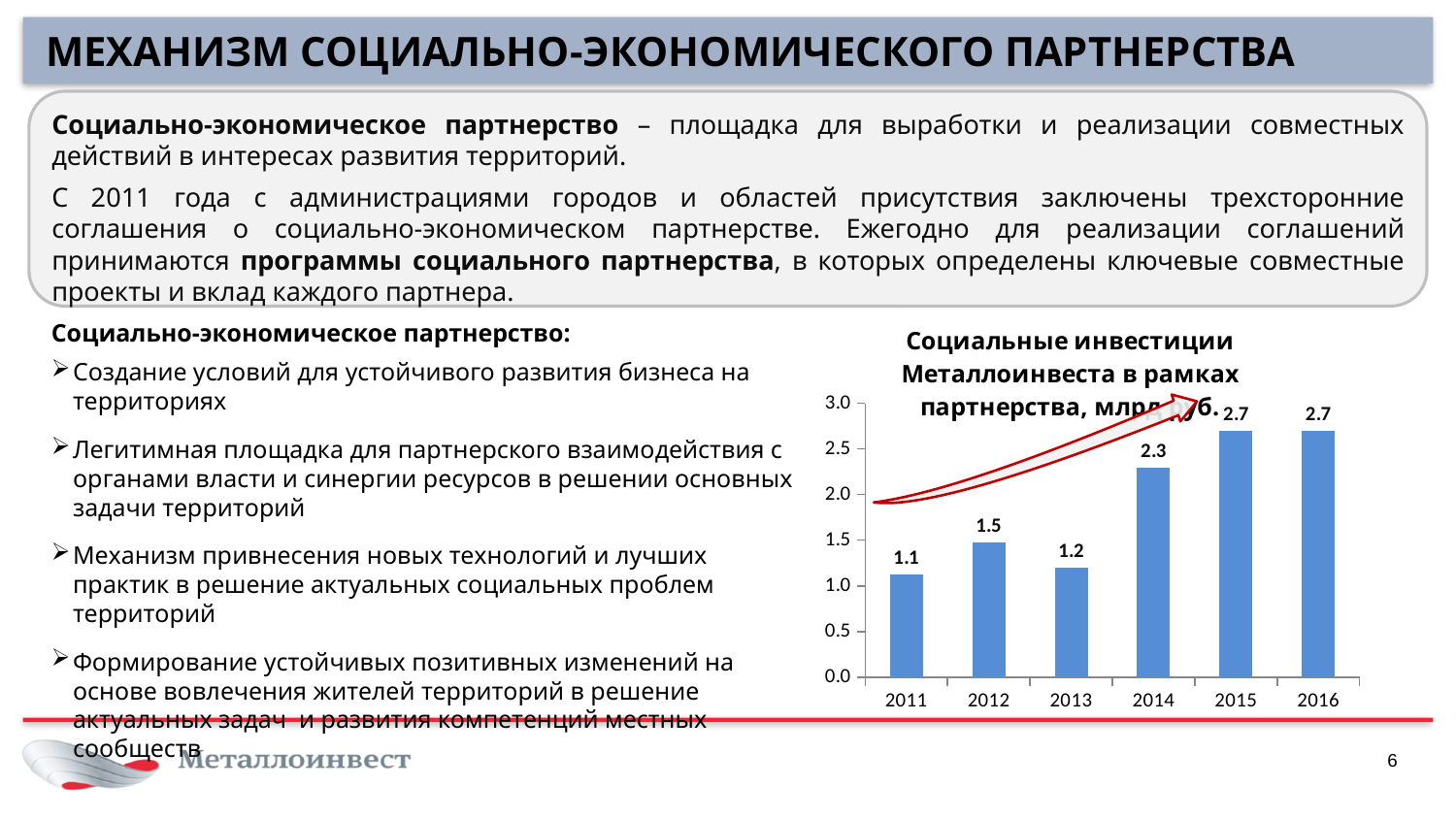
Is the value for 2016 greater or less than 2.0? greater What is the value for 2012 in the chart? 1.5 What is the value for 2011 in the chart? 1.1 Which is larger, the value for 2012 or the value for 2013? 2012 What is the value for 2014 in the chart? 2.3 Which year has the lowest value in the chart? 2011 What kind of chart is shown on the slide? bar chart What is the difference between the values for 2014 and 2013? 1.1 What is the highest value shown in the chart? 2.7 What is the difference between the values for 2015 and 2011? 1.6 How many years are shown on the x axis of the chart? 6 Do the values rise or fall from 2013 to 2015? rise